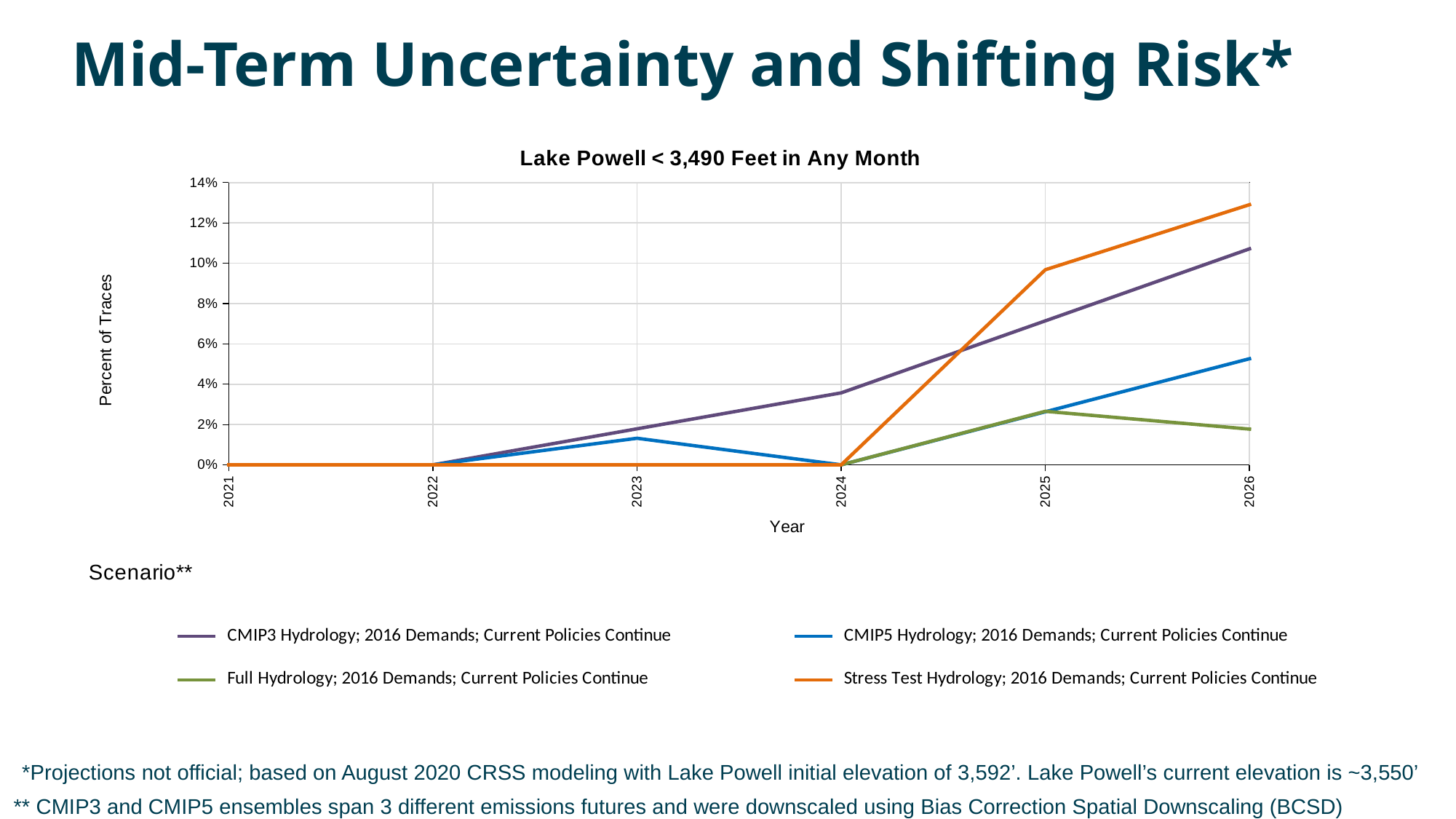
How many years are shown along the x axis? 6 What kind of chart is shown on the slide? line chart What is the value for the Stress Test Hydrology series in 2024? 0% What is the value for the CMIP5 Hydrology series in 2021? 0% What is the title of the chart? Lake Powell < 3,490 Feet in Any Month How many series does the legend list? 4 Does the Full Hydrology series rise or fall between 2025 and 2026? fall Is the value for the CMIP5 Hydrology series in 2026 greater or less than 6%? less Which series has the lowest value in 2026? Full Hydrology; 2016 Demands; Current Policies Continue In 2025, which is larger: the CMIP3 Hydrology value or the Stress Test Hydrology value? Stress Test Hydrology Which series has the highest value in 2026? Stress Test Hydrology; 2016 Demands; Current Policies Continue Is the value for the Stress Test Hydrology series in 2026 greater or less than 12%? greater